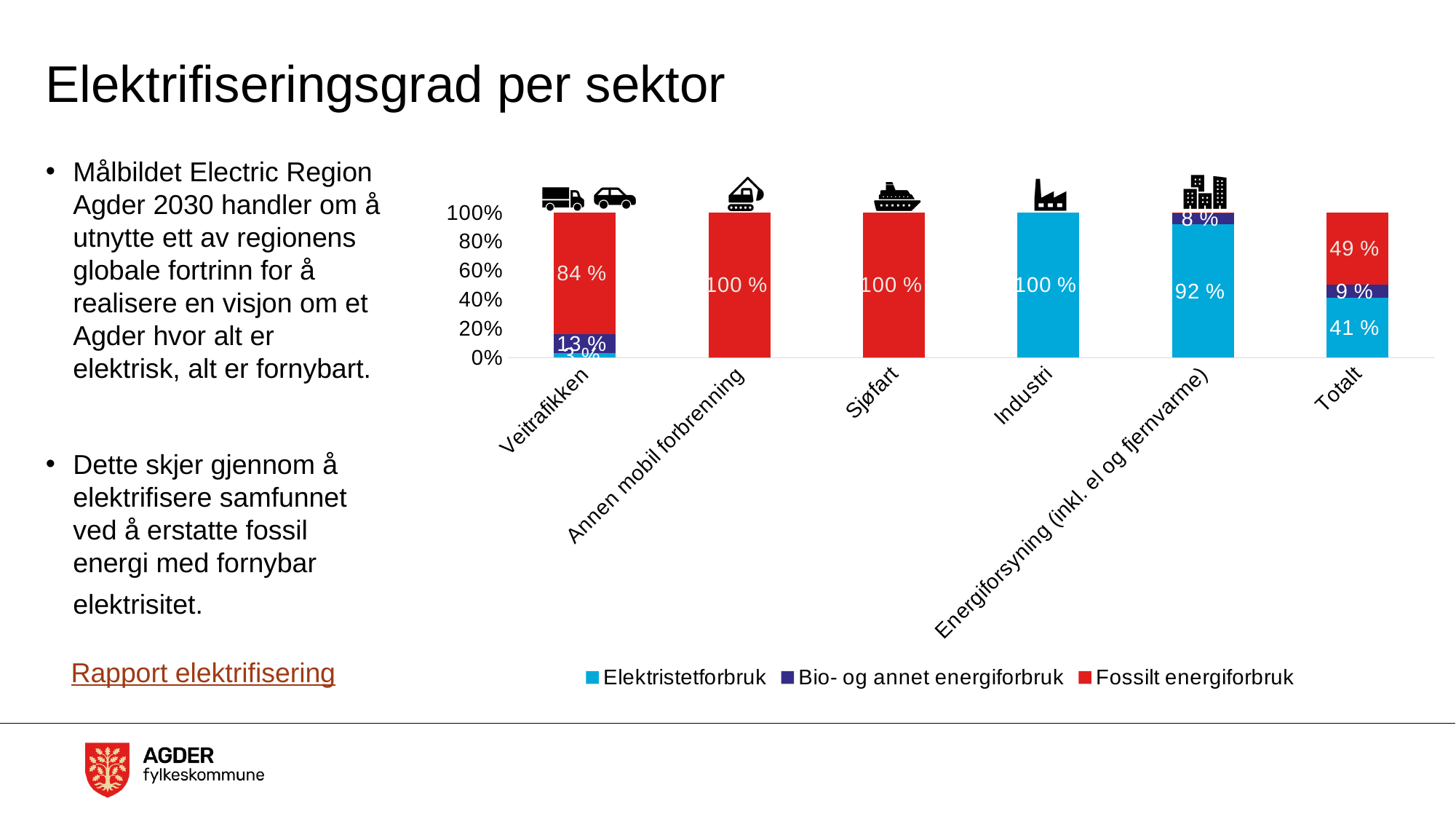
Which series is shown in red in the chart? Fossilt energiforbruk How many sectors (categories) are shown on the x axis of the chart? 6 What is the difference between the Fossilt energiforbruk share and the Elektristetforbruk share for Totalt? 8 % What is the Fossilt energiforbruk share for Veitrafikken? 84 % What kind of chart is shown on the slide? stacked bar chart What is the Elektristetforbruk share for Industri? 100 % What is the Elektristetforbruk share for Energiforsyning (inkl. el og fjernvarme)? 92 % How many series does the chart legend list? 3 What is the Bio- og annet energiforbruk share for Veitrafikken? 13 % Which sector has the highest Bio- og annet energiforbruk share? Veitrafikken What is the Fossilt energiforbruk share for Totalt? 49 % Which is larger for Totalt: the Elektristetforbruk share or the Fossilt energiforbruk share? Fossilt energiforbruk